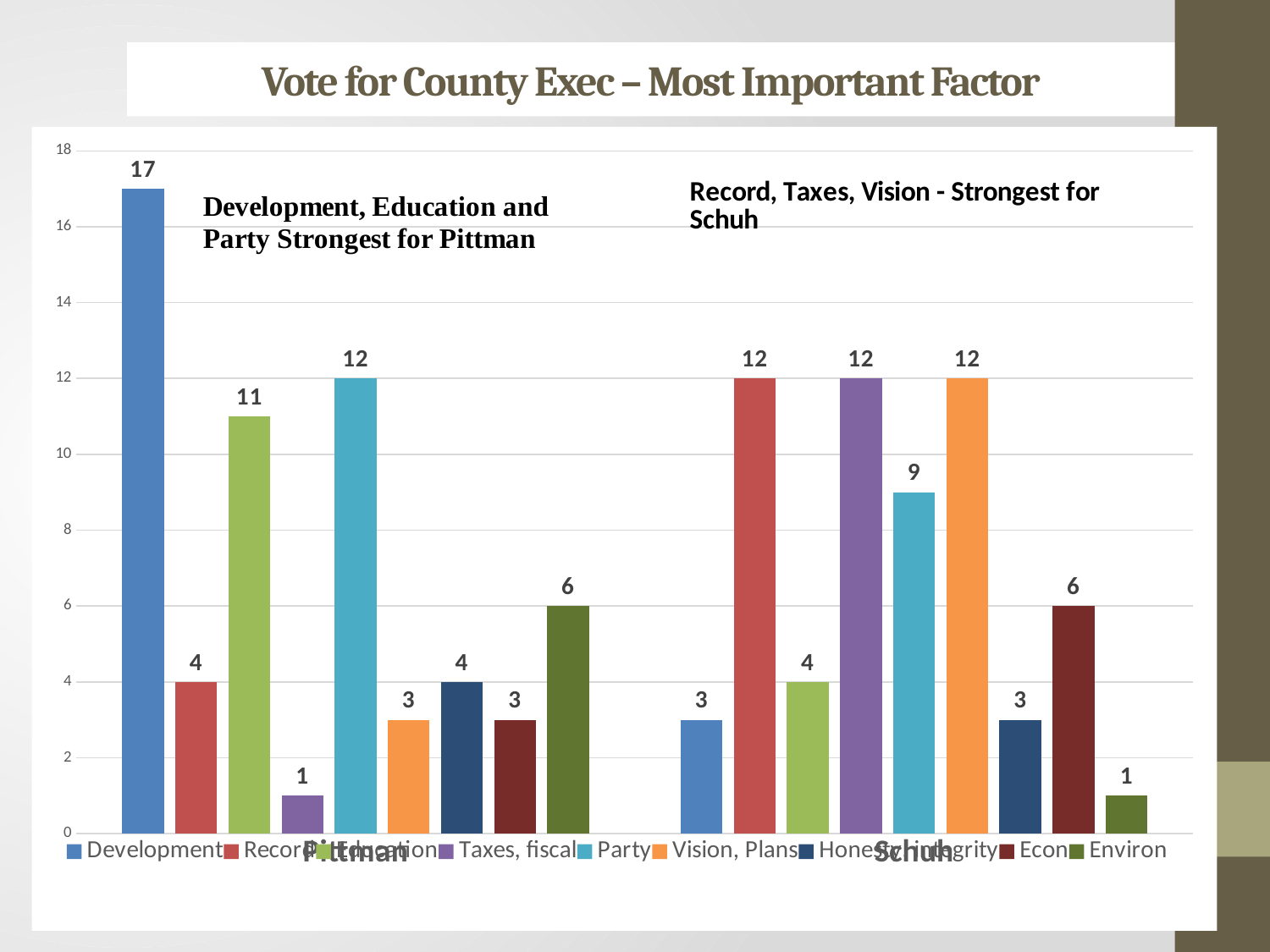
Which is larger, the Econ value for Pittman or for Schuh? Schuh How many categories are shown on the x axis? 2 Which factor has the lowest value for Pittman? Taxes, fiscal What kind of chart is shown on the slide? Bar chart What is the value for Party for Schuh? 9 How many series does the legend list? 9 What is the value for Development for Pittman? 17 What is the value for Environ for Schuh? 1 What is the value for Vision, Plans for Pittman? 3 Which factor has the highest value for Pittman? Development Which factor has the lowest value for Schuh? Environ What is the difference between the Development values for Pittman and Schuh? 14